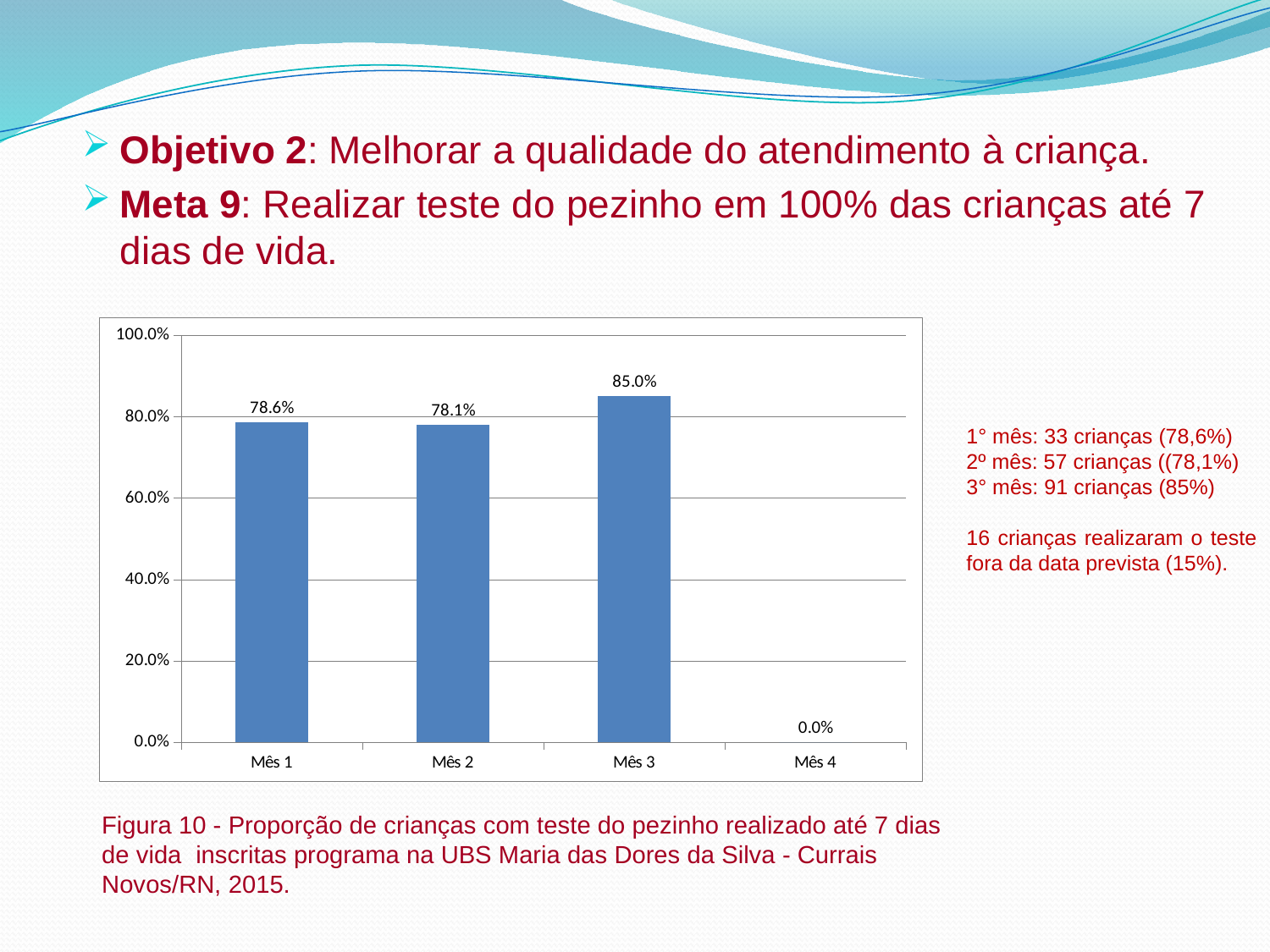
What kind of chart is shown on the slide? Bar chart Which month has the lowest value? Mês 4 What is the maximum value shown on the y axis? 100.0% Which month has the highest value? Mês 3 What is the difference between the values for Mês 1 and Mês 2? 0.5% How many months are shown on the x axis? 4 What is the difference between the values for Mês 3 and Mês 1? 6.4% What is the value for Mês 4? 0.0% What is the value for Mês 2? 78.1% What is the value for Mês 1? 78.6% What is the value for Mês 3? 85.0% Which is larger, the value for Mês 3 or the value for Mês 2? Mês 3